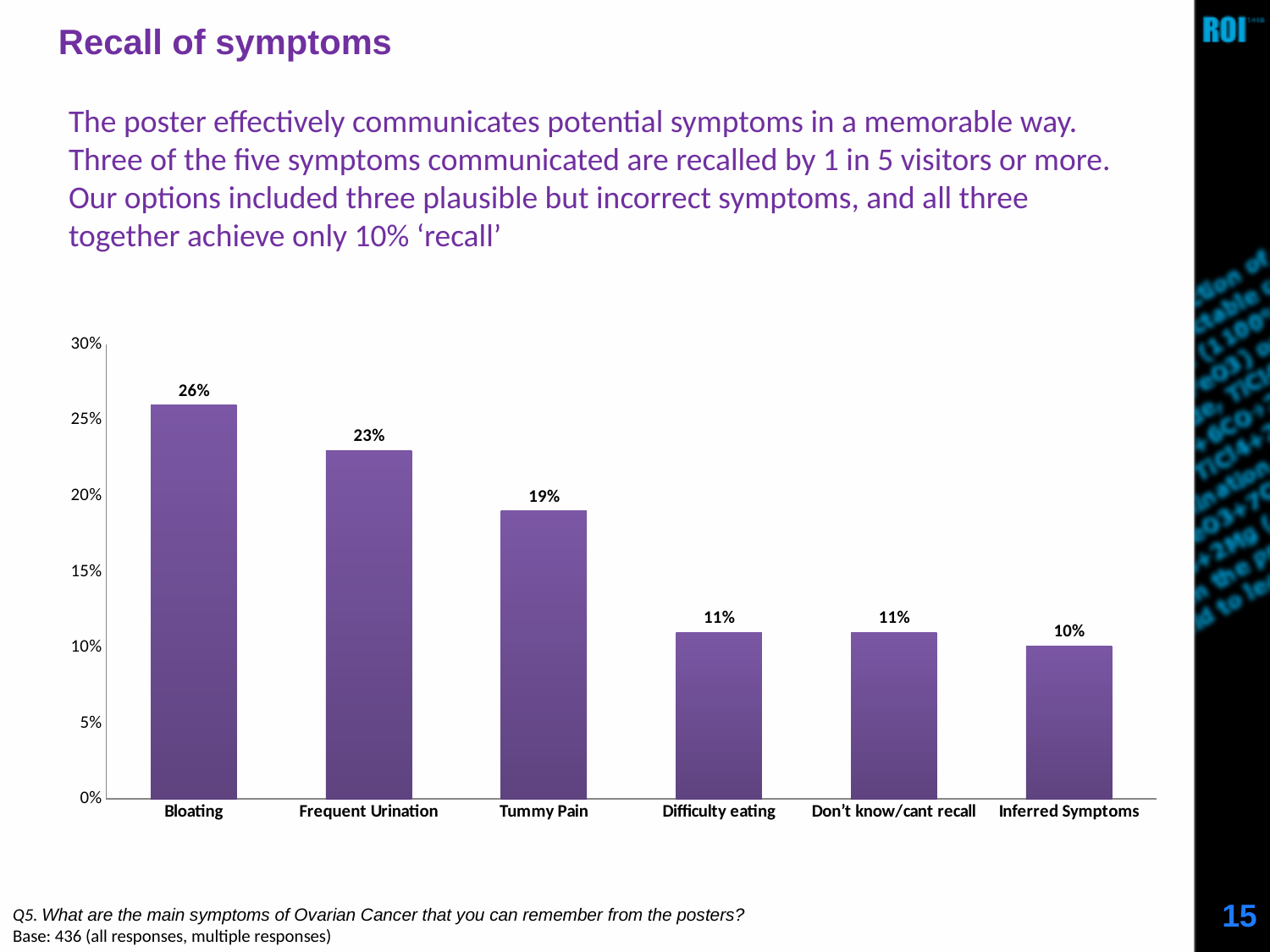
Do the values rise or fall from left to right along the x axis? fall What is the value for Inferred Symptoms? 10% Which is larger, the value for Frequent Urination or the value for Difficulty eating? Frequent Urination Which category has the highest value? Bloating How many categories are shown on the x axis? 6 Which category has the lowest value? Inferred Symptoms What is the value for Frequent Urination? 23% What kind of chart is shown on the slide? bar chart What is the difference between the values for Bloating and Tummy Pain? 7% What is the value for Bloating? 26% Is the value for Tummy Pain greater or less than 15%? greater What is the value for Tummy Pain? 19%